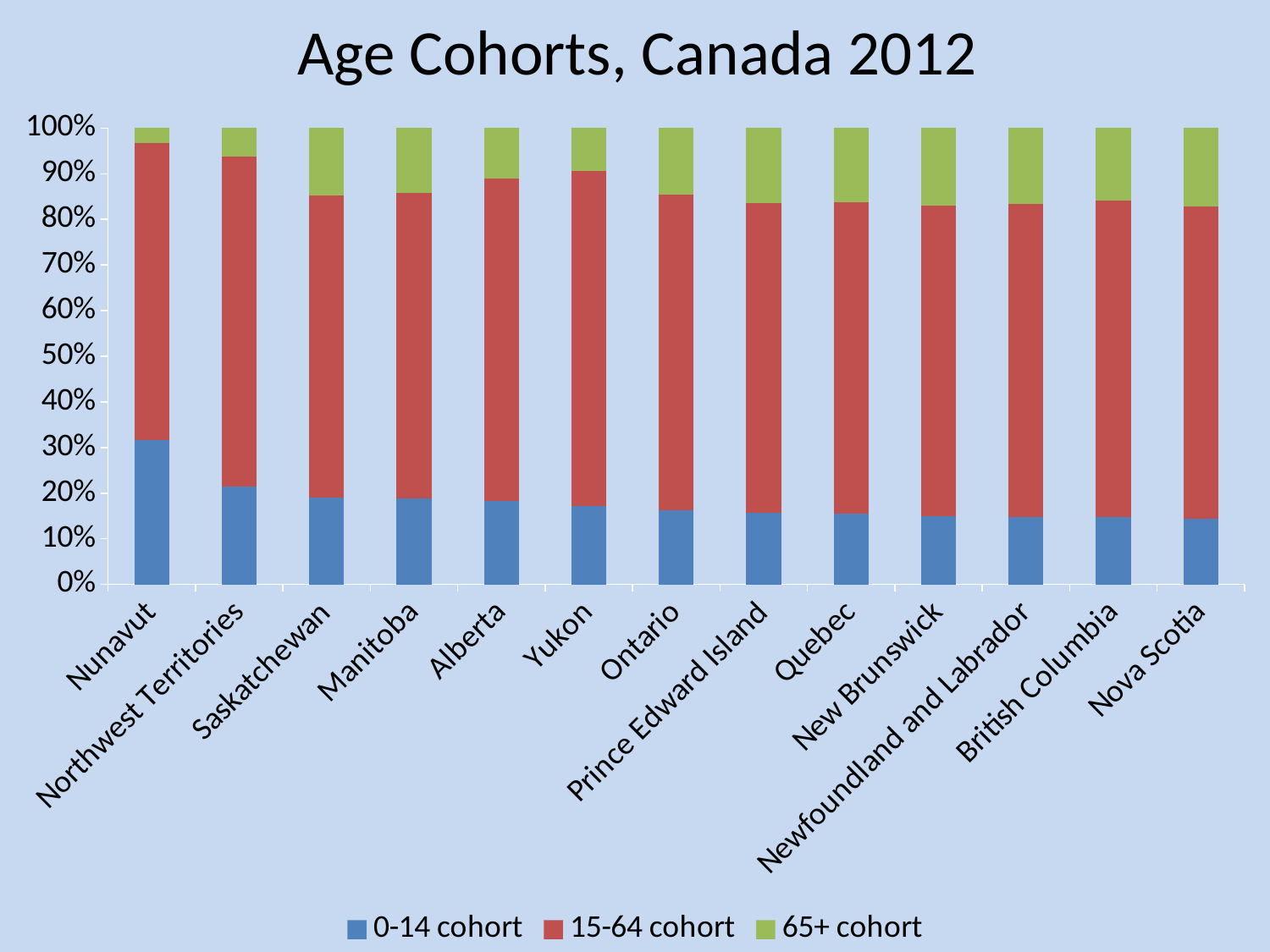
What type of chart is shown on the slide? Stacked bar chart How many provinces and territories are shown on the x axis? 13 Does the 0-14 cohort share generally rise or fall moving from left to right along the x axis? fall Which province or territory has the largest 0-14 cohort share? Nunavut How many series does the legend list? 3 Is the 0-14 cohort share for Nunavut greater or less than 30%? greater Is the 65+ cohort share for Northwest Territories greater or less than 10%? less What is the title of the chart? Age Cohorts, Canada 2012 What colour represents the 65+ cohort in the chart? Green Which is larger, the 0-14 cohort share for Nunavut or for Nova Scotia? Nunavut Is the 0-14 cohort share for Nova Scotia greater or less than 20%? less Which province or territory has the smallest 65+ cohort share? Nunavut